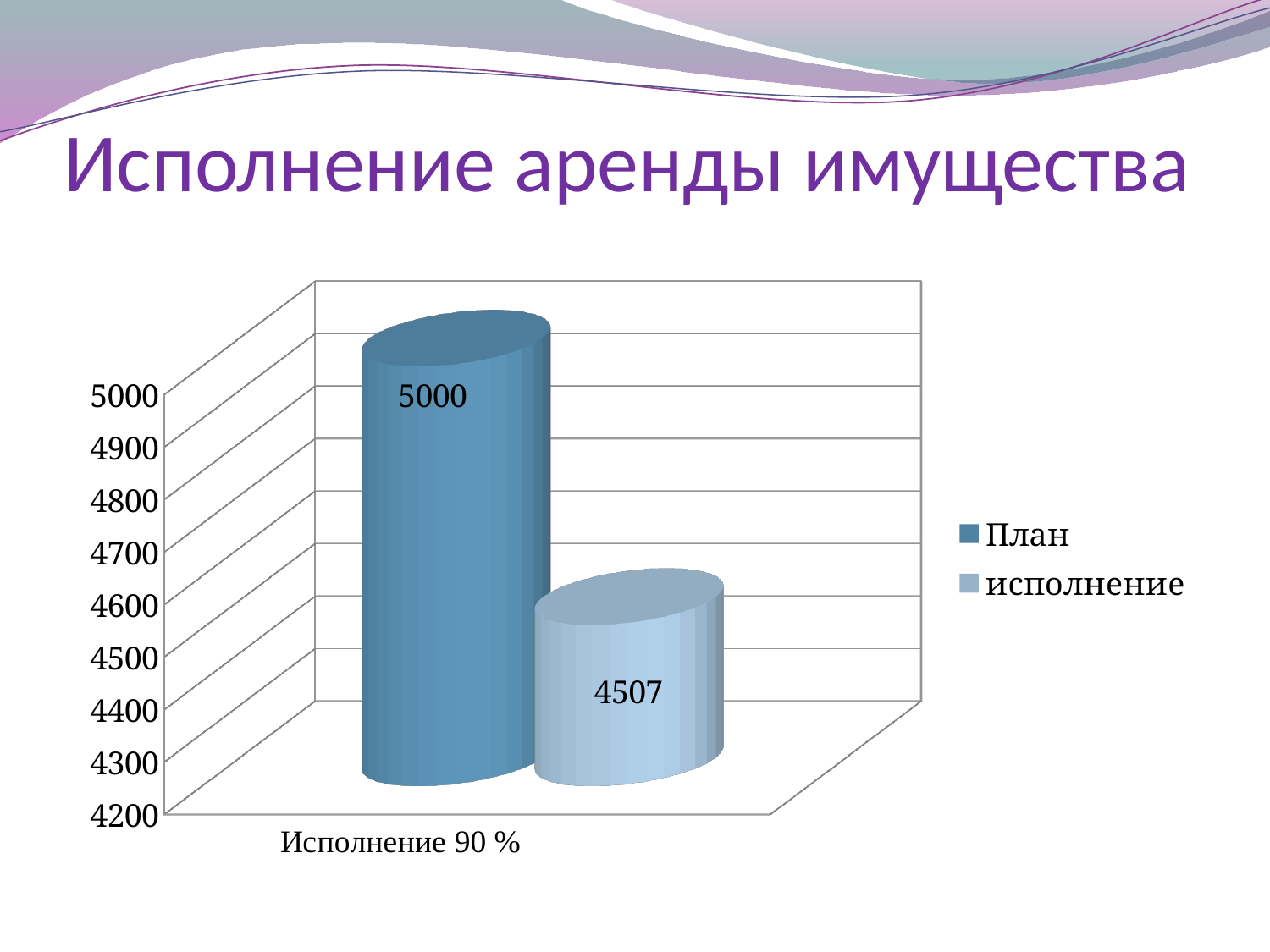
What kind of chart is shown on the slide? bar chart Is the value for исполнение greater or less than 4600? less How many bars are plotted in the chart? 2 What is the value of the План series? 5000 What is the value of the исполнение series? 4507 What is the difference between the План value and the исполнение value? 493 What is the title of the slide? Исполнение аренды имущества How many series does the legend list? 2 What is the category label shown on the x axis? Исполнение 90 % Which series has the lowest value? исполнение Which series has the higher value, План or исполнение? План